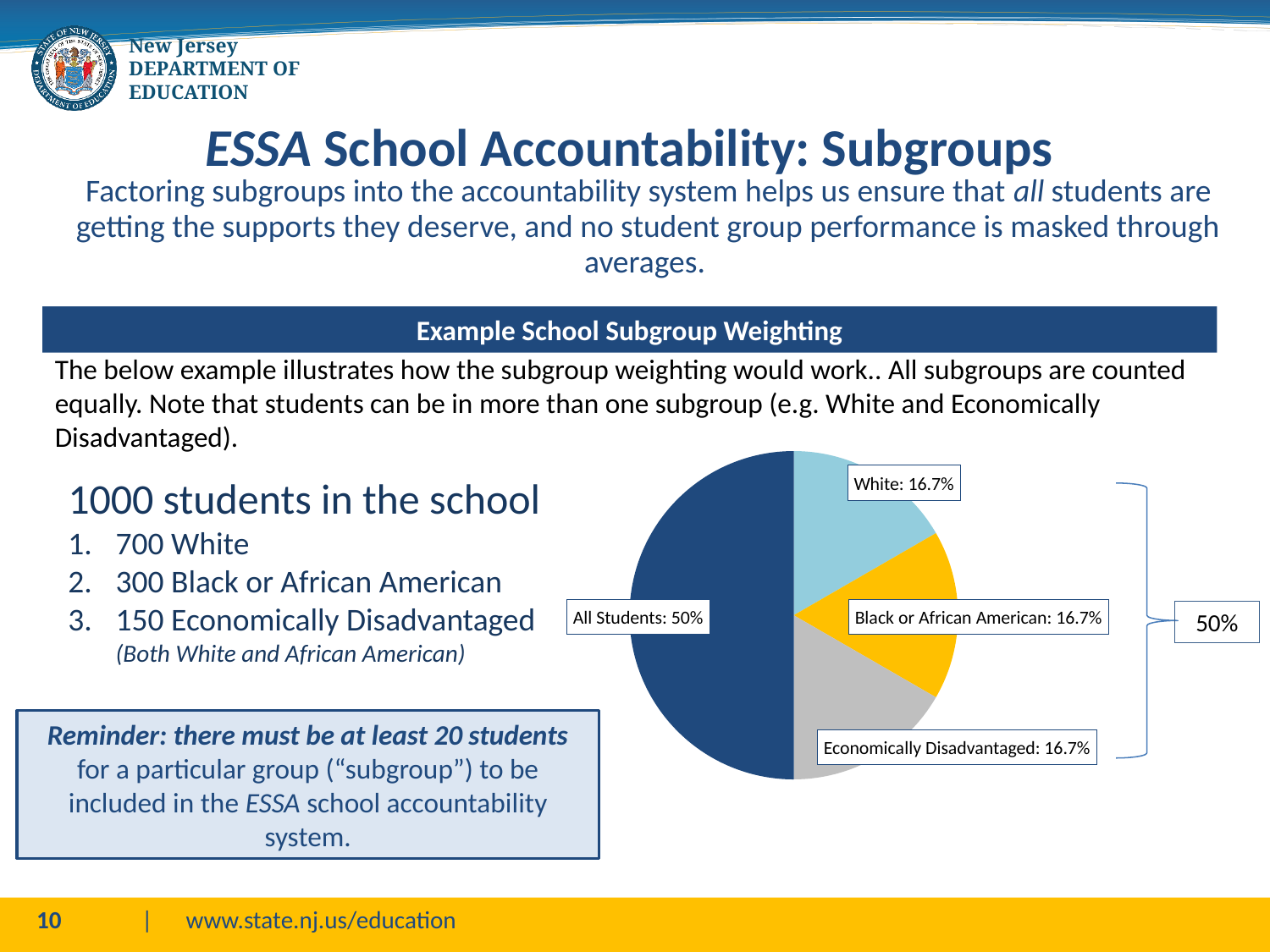
What colour is the Black or African American slice in the pie chart? Yellow What is the combined share of the White, Black or African American and Economically Disadvantaged slices, as labelled by the bracket on the slide? 50% Which is larger in the pie chart, the All Students slice or the White slice? All Students What share of the pie does the Black or African American slice represent? 16.7% What kind of chart is shown on the slide? Pie chart What share of the pie does the White slice represent? 16.7% What colour is the All Students slice in the pie chart? Dark blue What share of the pie does the Economically Disadvantaged slice represent? 16.7% Which slice of the pie chart is the largest? All Students What share of the pie does the All Students slice represent? 50% How many slices does the pie chart have? 4 What is the difference between the All Students share and the Economically Disadvantaged share in the pie chart? 33.3%